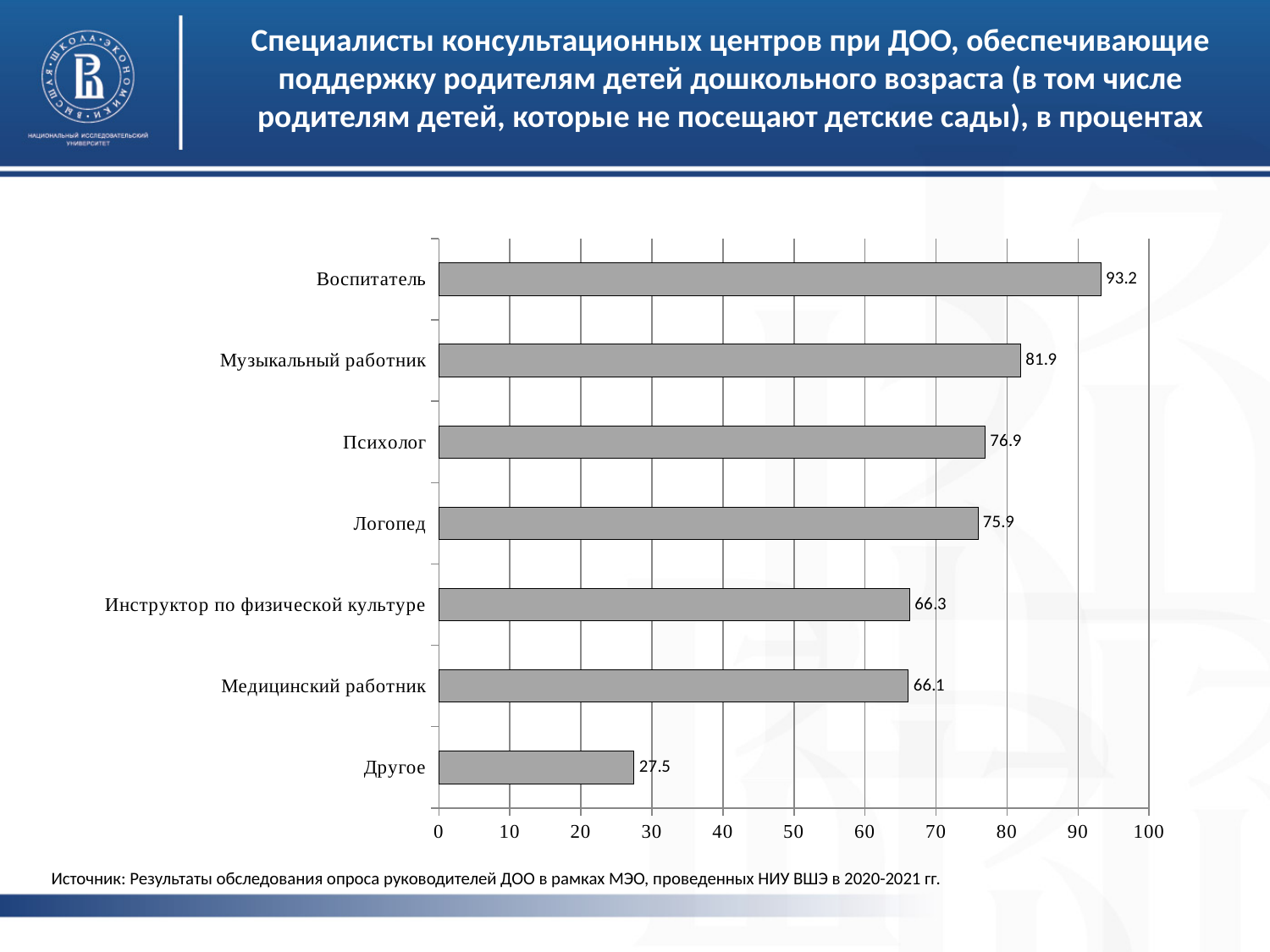
How many categories are shown in the chart? 7 What is the value for Логопед? 75.9 What kind of chart is shown on the slide? bar chart Which is larger, the value for Музыкальный работник or the value for Психолог? Музыкальный работник Is the value for Инструктор по физической культуре greater or less than 70? less Which category has the lowest value? Другое What is the value for Другое? 27.5 What is the maximum value shown on the horizontal axis? 100 What is the value for Воспитатель? 93.2 What is the difference between the values for Психолог and Другое? 49.4 Which category has the highest value? Воспитатель What is the difference between the values for Воспитатель and Музыкальный работник? 11.3